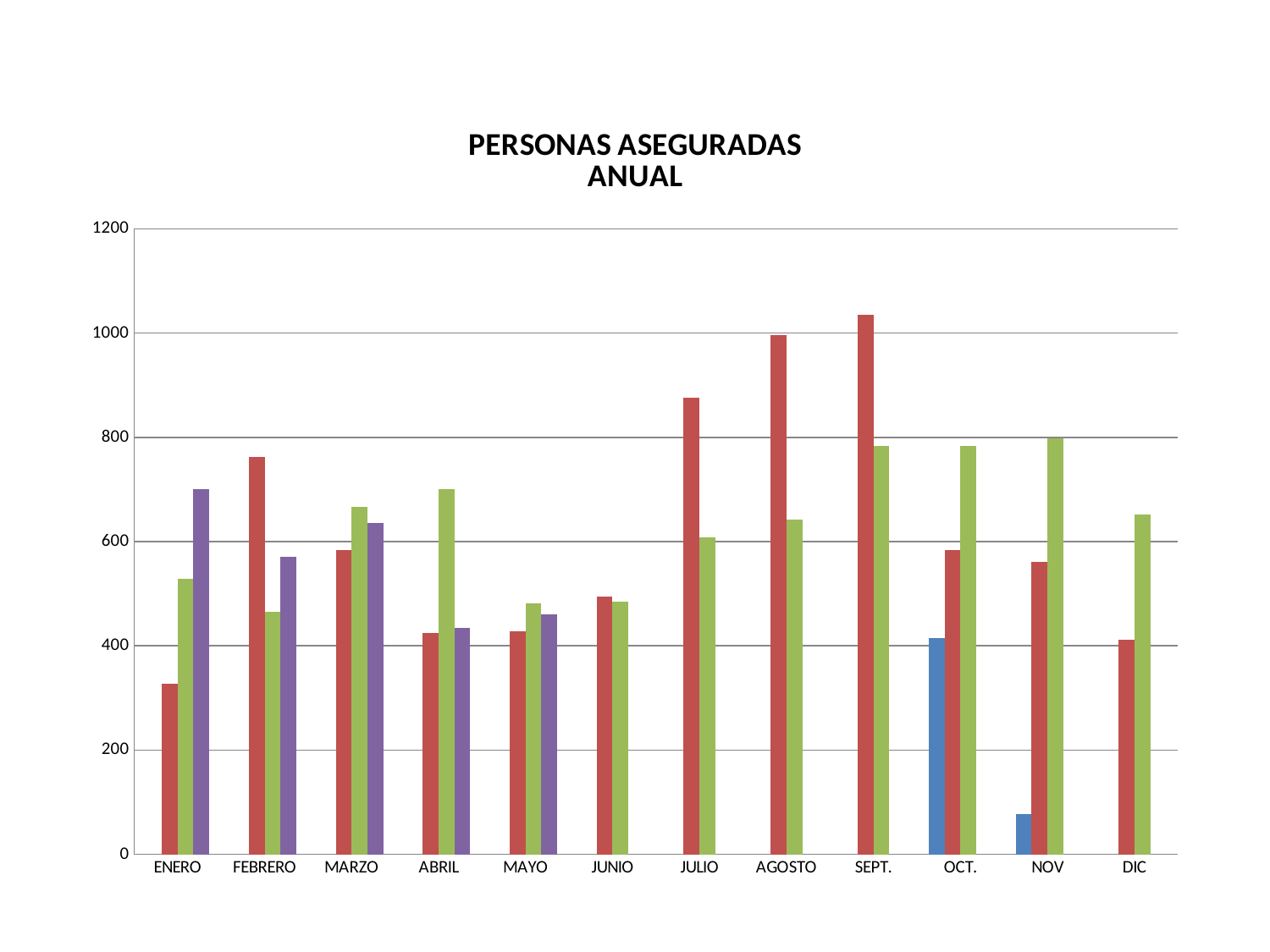
What is the title of the chart? PERSONAS ASEGURADAS ANUAL Is the red bar for SEPT. greater or less than 1000? greater In ENERO, which is larger, the red bar or the green bar? the green bar What kind of chart is shown on the slide? bar chart Is the red bar for ENERO greater or less than 400? less Is the red bar for JULIO greater or less than 800? greater Do the red bars rise or fall from JUNIO to SEPT.? rise How many different bar colours appear in the chart? 4 In which month is the red bar the shortest? ENERO In which month is the red bar the tallest? SEPT. How many months are shown on the x axis? 12